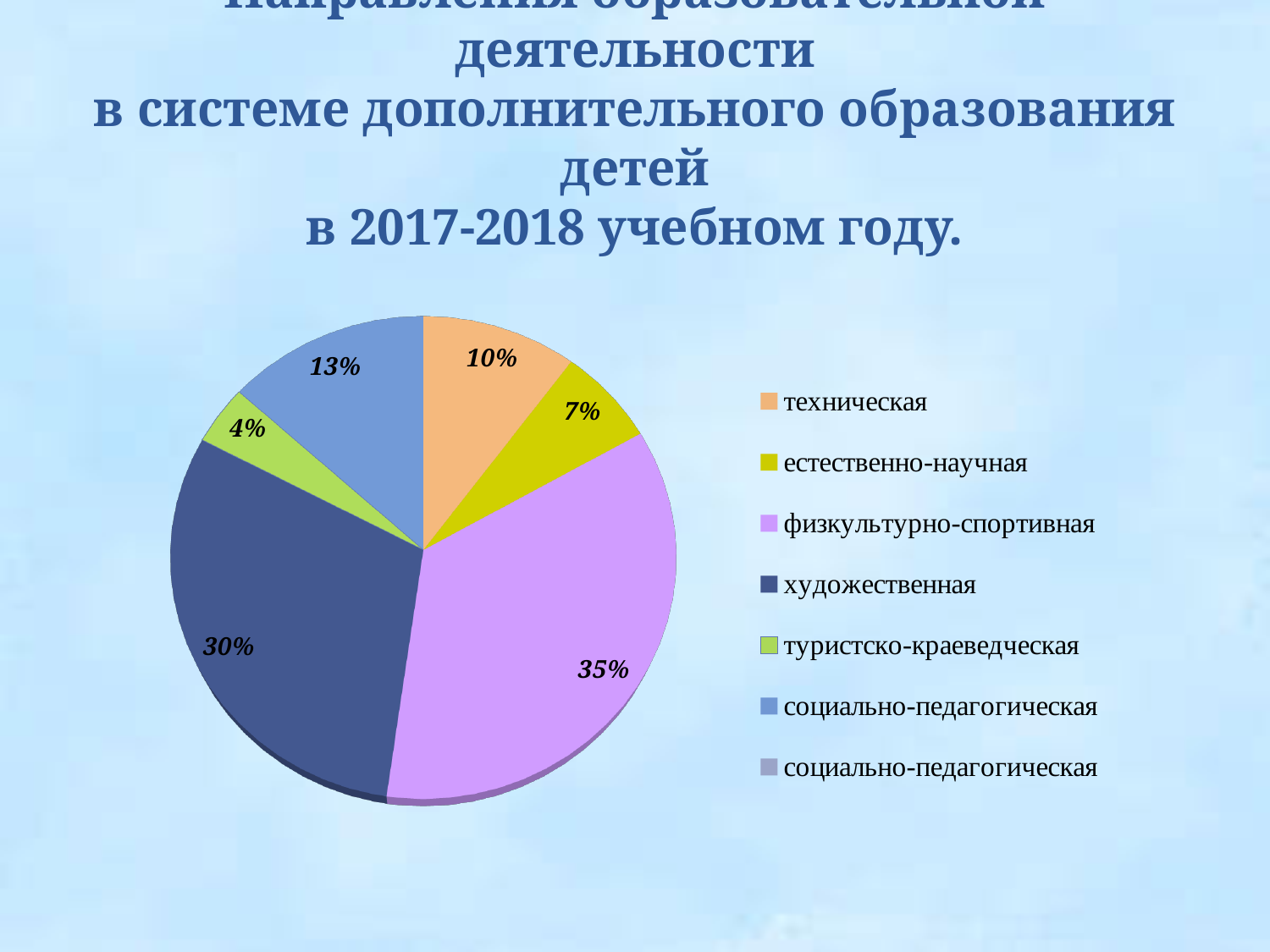
Which category has the largest share of the pie? физкультурно-спортивная What percentage does the техническая slice show? 10% Which category has the smallest share of the pie? туристско-краеведческая Which is larger, the техническая slice or the естественно-научная slice? техническая What is the difference in percentage points between the физкультурно-спортивная and художественная slices? 5 How many entries does the legend list? 7 What percentage does the физкультурно-спортивная slice show? 35% What kind of chart is shown on the slide? pie chart What percentage does the художественная slice show? 30% What percentage does the естественно-научная slice show? 7% What colour is the художественная slice in the pie chart? dark blue What percentage does the туристско-краеведческая slice show? 4%